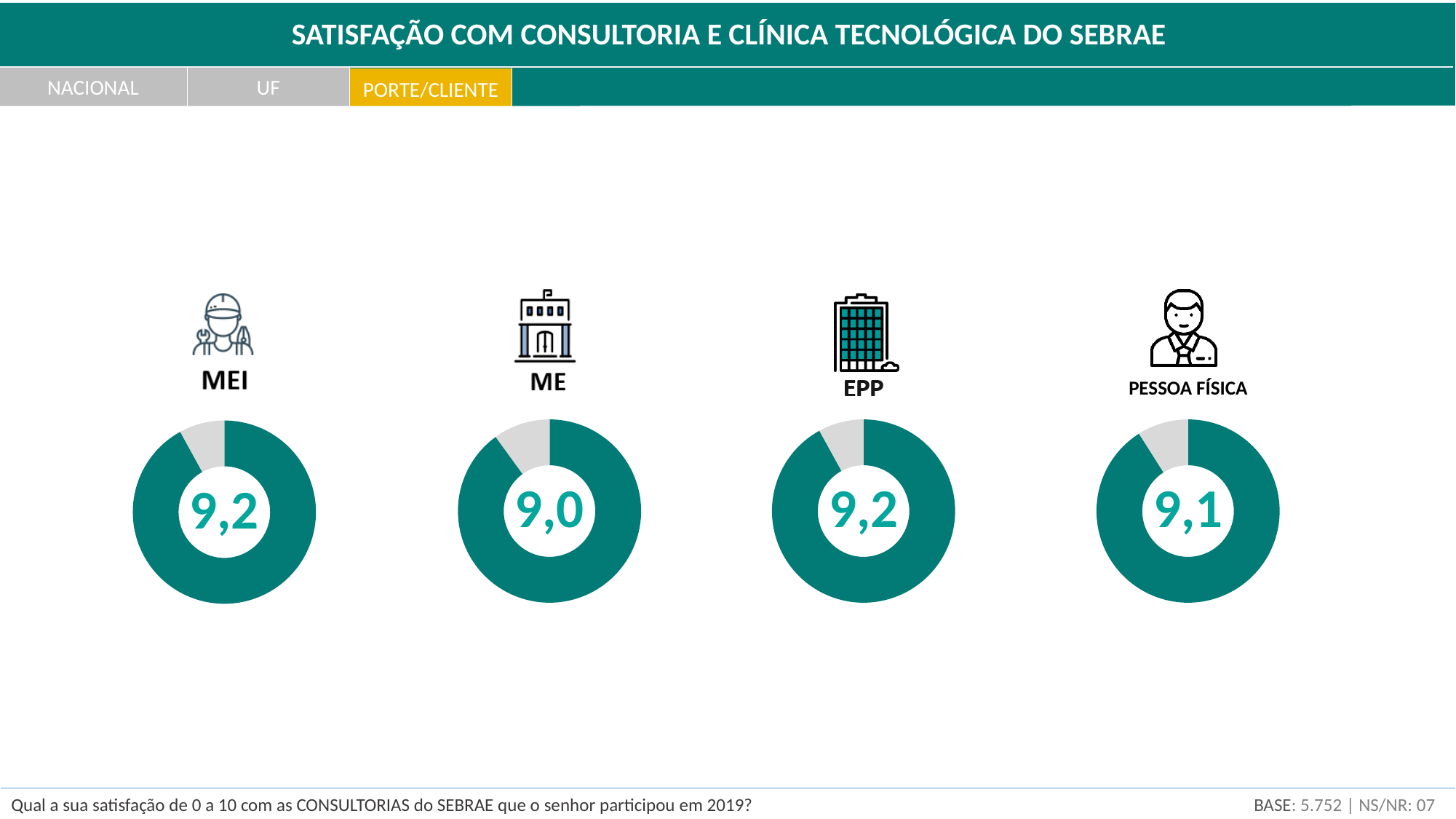
What is the satisfaction score shown for MEI? 9,2 What kind of chart is used to display each group's score? Donut chart Which group has the lowest satisfaction score? ME What is the difference between the satisfaction scores of EPP and ME? 0,2 Which has a higher satisfaction score, PESSOA FÍSICA or ME? PESSOA FÍSICA Which groups share the highest satisfaction score? MEI and EPP What is the title of the slide? SATISFAÇÃO COM CONSULTORIA E CLÍNICA TECNOLÓGICA DO SEBRAE What is the satisfaction score shown for EPP? 9,2 What is the satisfaction score shown for ME? 9,0 Which has a higher satisfaction score, MEI or ME? MEI What is the satisfaction score shown for PESSOA FÍSICA? 9,1 How many groups (donut charts) are shown on the slide? 4